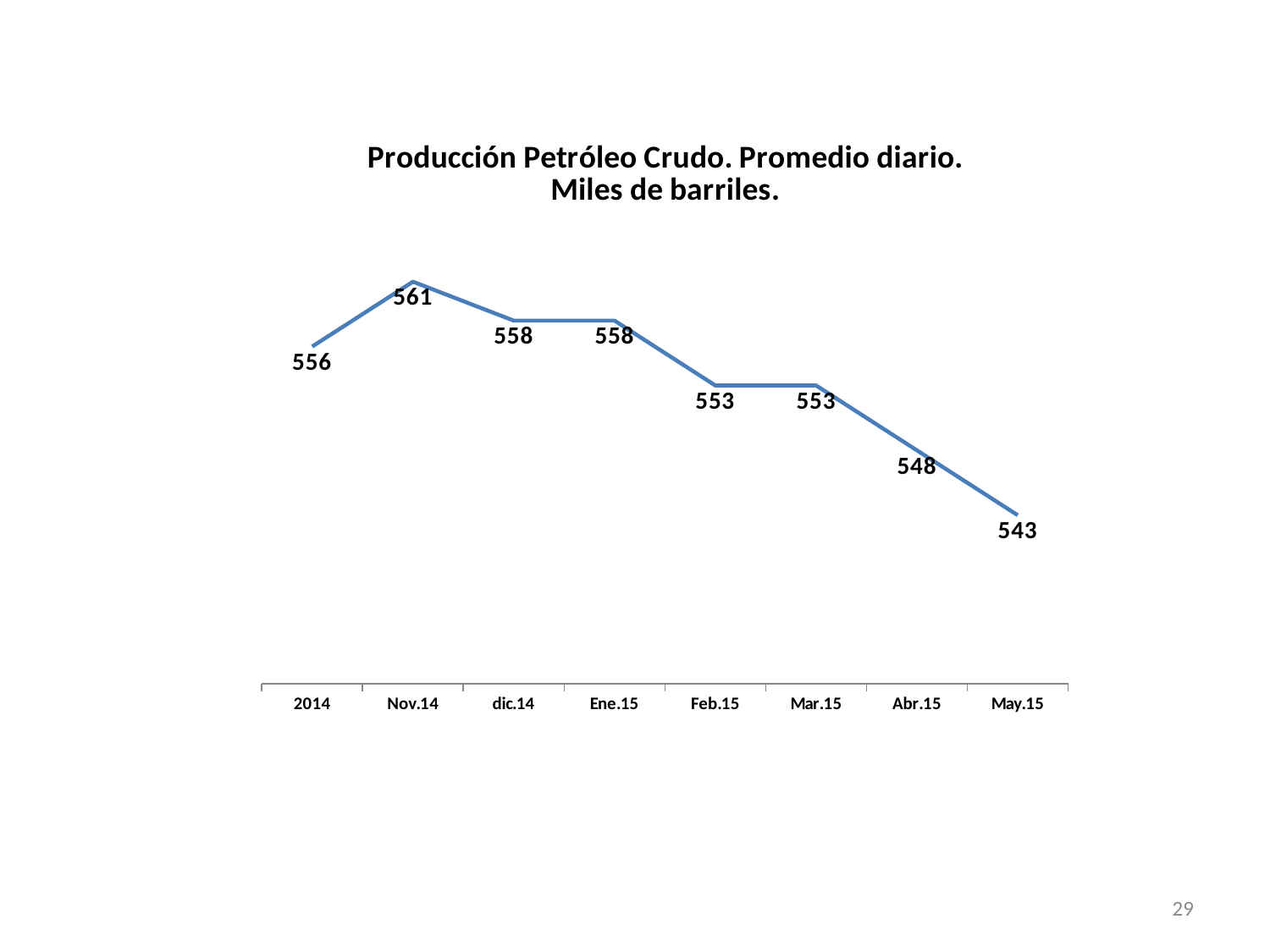
What is the value for 2014? 556 Do the values rise or fall from Nov.14 to May.15? fall What is the value for Nov.14? 561 How many periods are plotted on the x axis? 8 What is the difference between the values for Nov.14 and May.15? 18 Which period has the lowest value? May.15 Which is larger, the value for 2014 or the value for Abr.15? 2014 What is the value for May.15? 543 What kind of chart is this? line chart Which period has the highest value? Nov.14 What is the title of the chart? Producción Petróleo Crudo. Promedio diario. Miles de barriles. What is the difference between the values for Ene.15 and Feb.15? 5